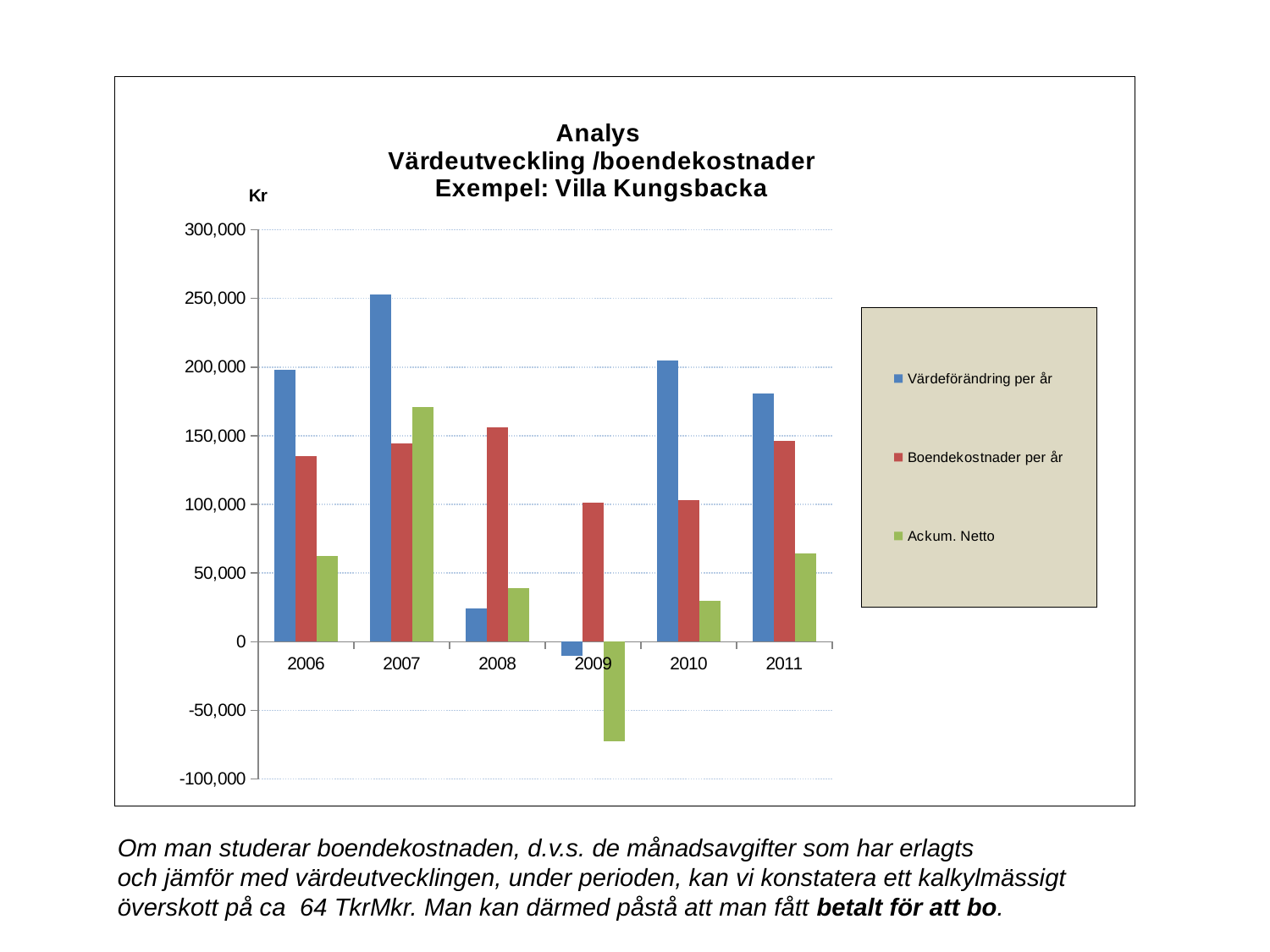
How many series does the legend list? 3 In which year is Boendekostnader per år highest? 2008 How many years are shown on the x axis? 6 In which year is Ackum. Netto lowest? 2009 In which year is Värdeförändring per år lowest? 2009 What unit label is shown at the top of the y axis? Kr What kind of chart is shown on the slide? bar chart In which year is Värdeförändring per år highest? 2007 Is the value for Boendekostnader per år in 2009 greater or less than 150,000? less In which year is Ackum. Netto highest? 2007 Is the value for Värdeförändring per år in 2007 greater or less than 200,000? greater In 2008, which is larger: Värdeförändring per år or Boendekostnader per år? Boendekostnader per år